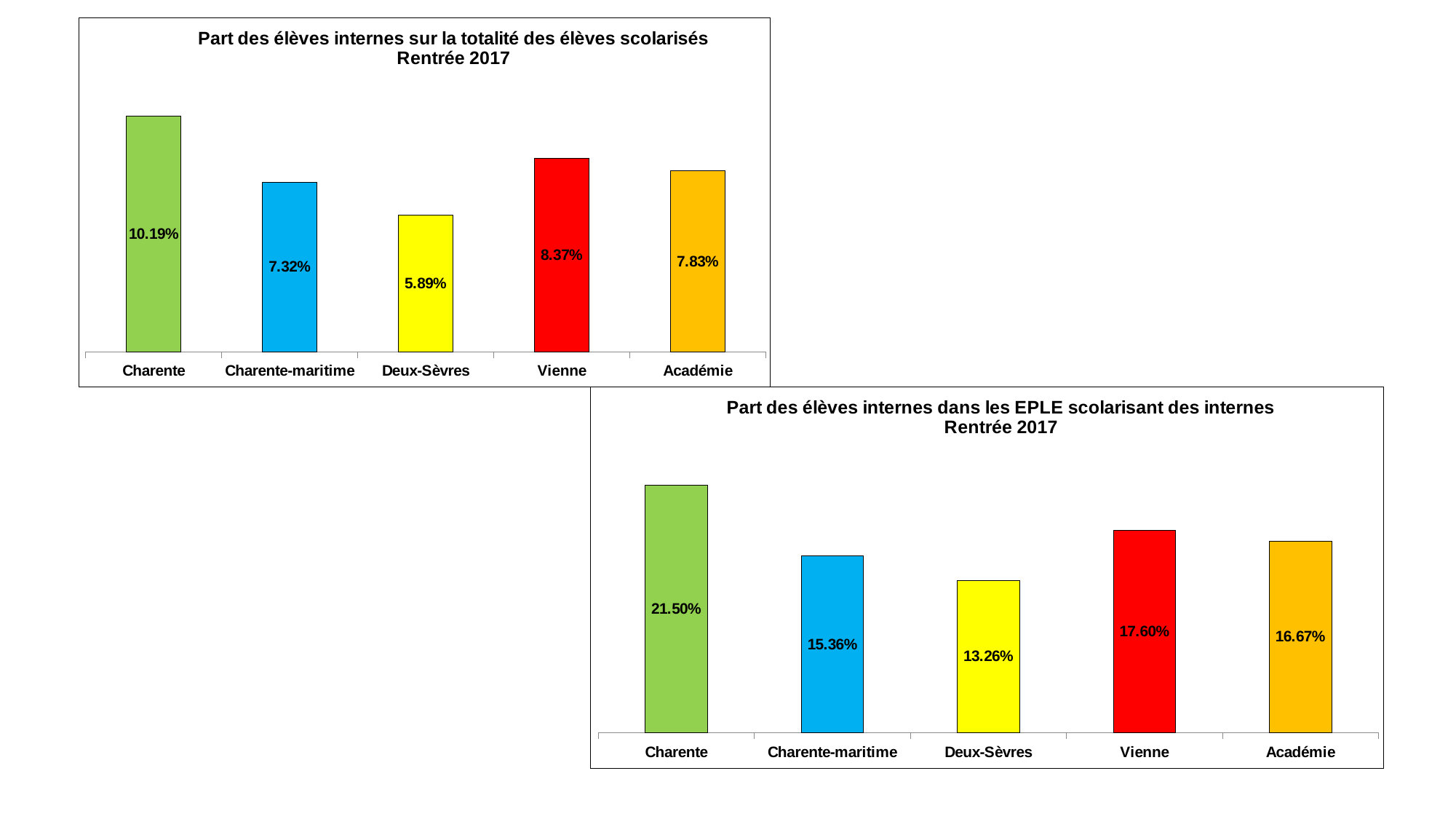
In the bottom-right chart 'Part des élèves internes dans les EPLE scolarisant des internes', what is the value for Deux-Sèvres? 13.26% In the top-left chart 'Part des élèves internes sur la totalité des élèves scolarisés', how many categories are shown? 5 In the bottom-right chart 'Part des élèves internes dans les EPLE scolarisant des internes', what is the difference between Charente and Académie? 4.83% In the bottom-right chart 'Part des élèves internes dans les EPLE scolarisant des internes', what is the value for Vienne? 17.60% In the top-left chart 'Part des élèves internes sur la totalité des élèves scolarisés', what is the value for Charente? 10.19% What kind of chart is the bottom-right chart 'Part des élèves internes dans les EPLE scolarisant des internes'? Bar chart In the top-left chart 'Part des élèves internes sur la totalité des élèves scolarisés', what is the value for Académie? 7.83% In the bottom-right chart 'Part des élèves internes dans les EPLE scolarisant des internes', what colour is the bar for Vienne? Red In the top-left chart 'Part des élèves internes sur la totalité des élèves scolarisés', which category has the lowest value? Deux-Sèvres In the top-left chart 'Part des élèves internes sur la totalité des élèves scolarisés', what is the difference between Charente and Charente-maritime? 2.87% In the top-left chart 'Part des élèves internes sur la totalité des élèves scolarisés', which is larger, Vienne or Académie? Vienne In the bottom-right chart 'Part des élèves internes dans les EPLE scolarisant des internes', which category has the highest value? Charente